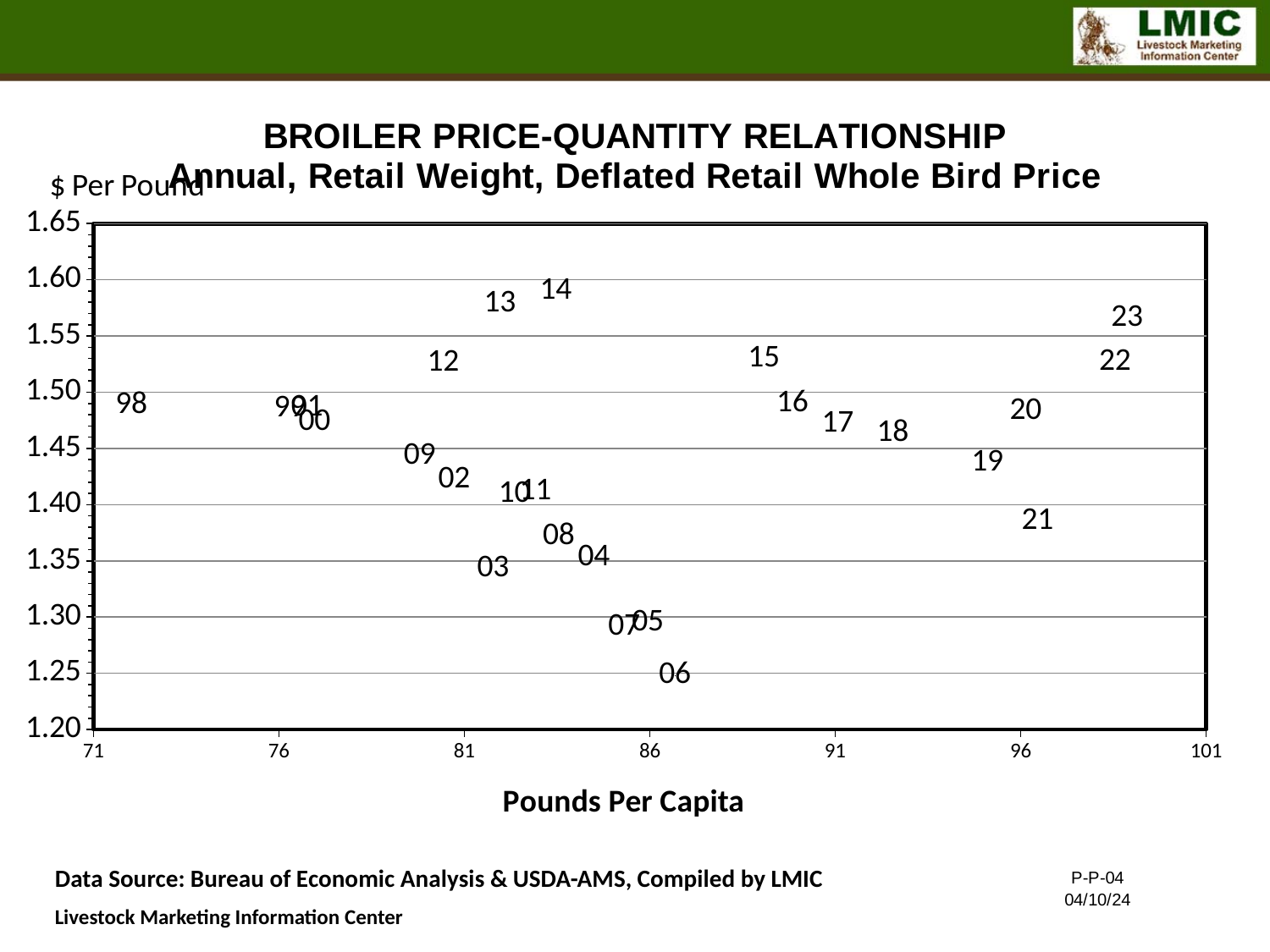
What kind of chart is shown on the slide? Scatter chart Which year has the higher pounds per capita, 98 or 23? 23 Is the pounds per capita for year 98 greater or less than 76? less Which year has the lowest pounds per capita on the chart? 98 Which year has the higher price, 06 or 14? 14 How many year points are plotted on the chart? 26 What is the title of the x axis of the chart? Pounds Per Capita Is the pounds per capita for year 23 greater or less than 96? greater Which year has the lowest deflated retail whole bird price on the chart? 06 What unit is shown on the y axis of the chart? $ Per Pound Is the price for year 06 greater or less than 1.30 $ per pound? less